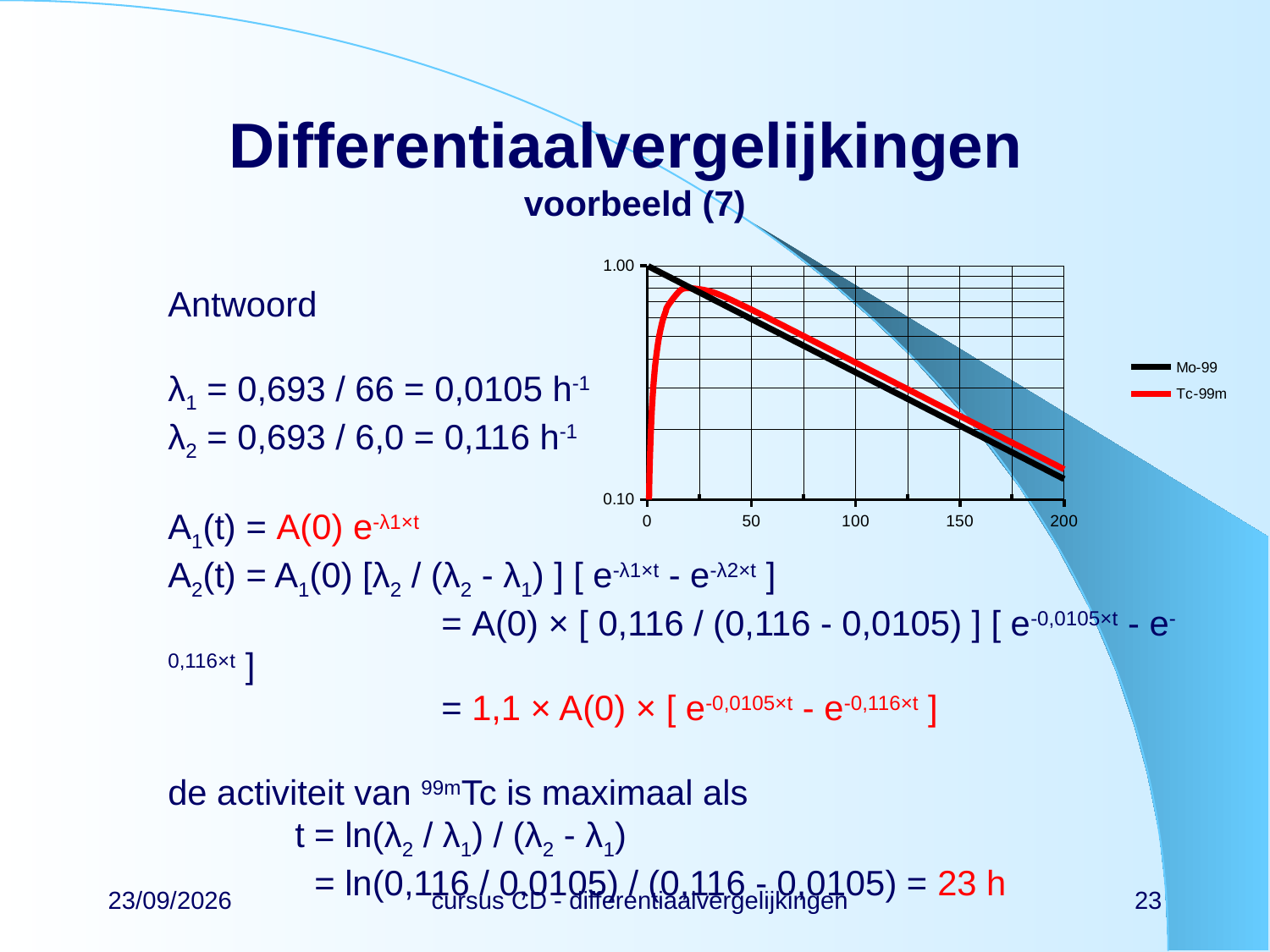
What is the largest value labelled on the chart's x axis? 200 Does the Mo-99 line rise or fall as the x axis increases? fall At x = 0, which series has the higher value, Mo-99 or Tc-99m? Mo-99 What is the highest value labelled on the chart's y axis? 1.00 What are the two series named in the chart legend? Mo-99 and Tc-99m Which colour is used for the Tc-99m line in the chart? red How many labelled tick marks are on the chart's x axis? 5 Is the value for Mo-99 at x = 100 greater or less than 0.10? greater Is the value for Tc-99m at x = 50 greater or less than 1.00? less What kind of chart is shown on the slide? line chart At x = 100, which series has the higher value, Mo-99 or Tc-99m? Tc-99m How many series does the chart legend list? 2